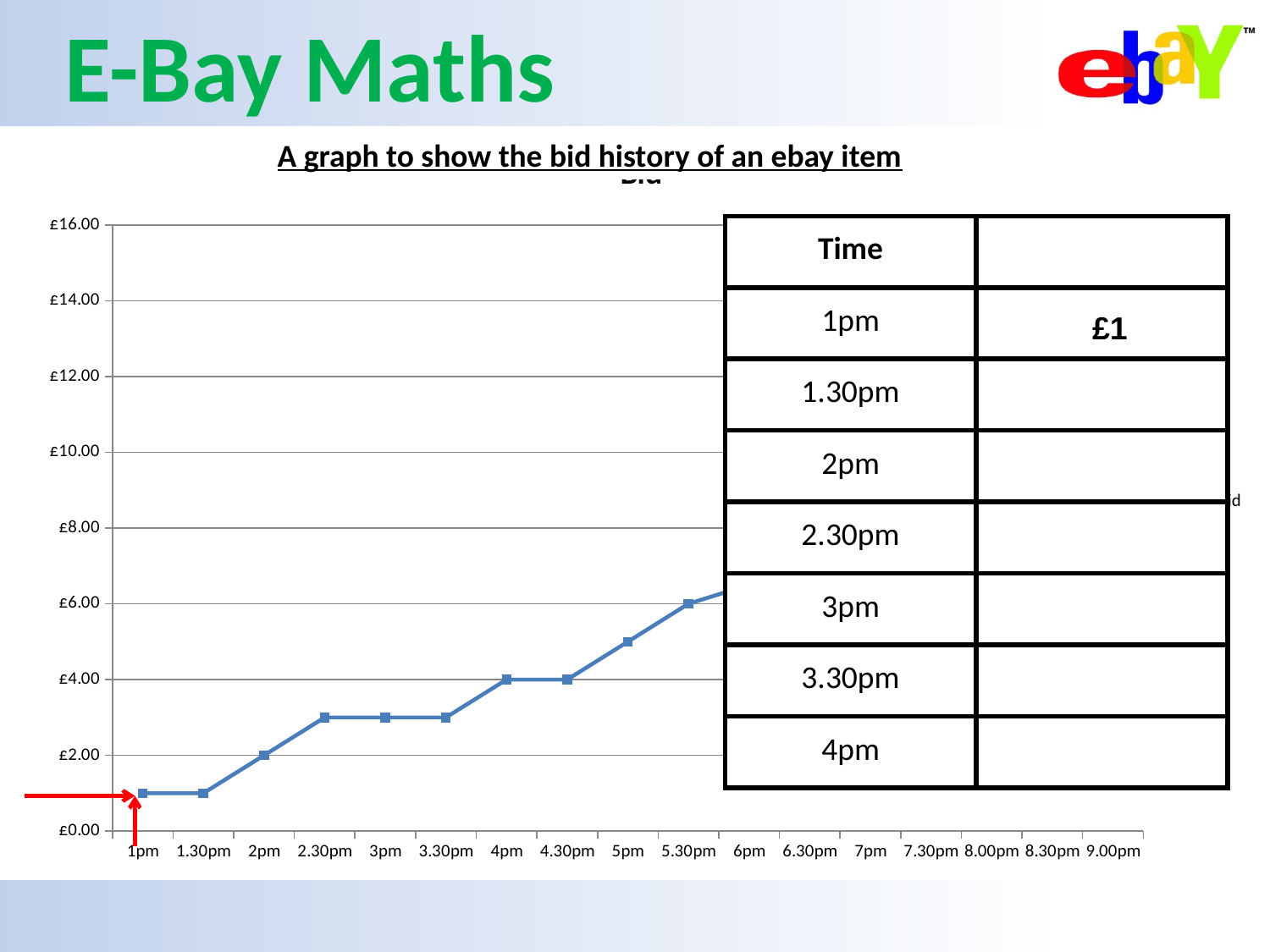
How many time labels are shown along the x axis of the chart? 17 What is the bid value at 5.30pm? £6.00 What is the bid value at 2pm? £2.00 What is the bid value at 4pm? £4.00 What kind of chart is shown on the slide? line chart What is the bid value at 1pm? £1 Is the bid value at 5pm greater or less than £4.00? greater What is the difference between the bid at 5.30pm and the bid at 2pm? £4.00 What is the title of the graph on the slide? A graph to show the bid history of an ebay item Is the bid value at 2.30pm greater or less than £4.00? less Do the bid values generally rise or fall from 1pm to 6pm? rise Which is larger, the bid at 5pm or the bid at 2pm? 5pm